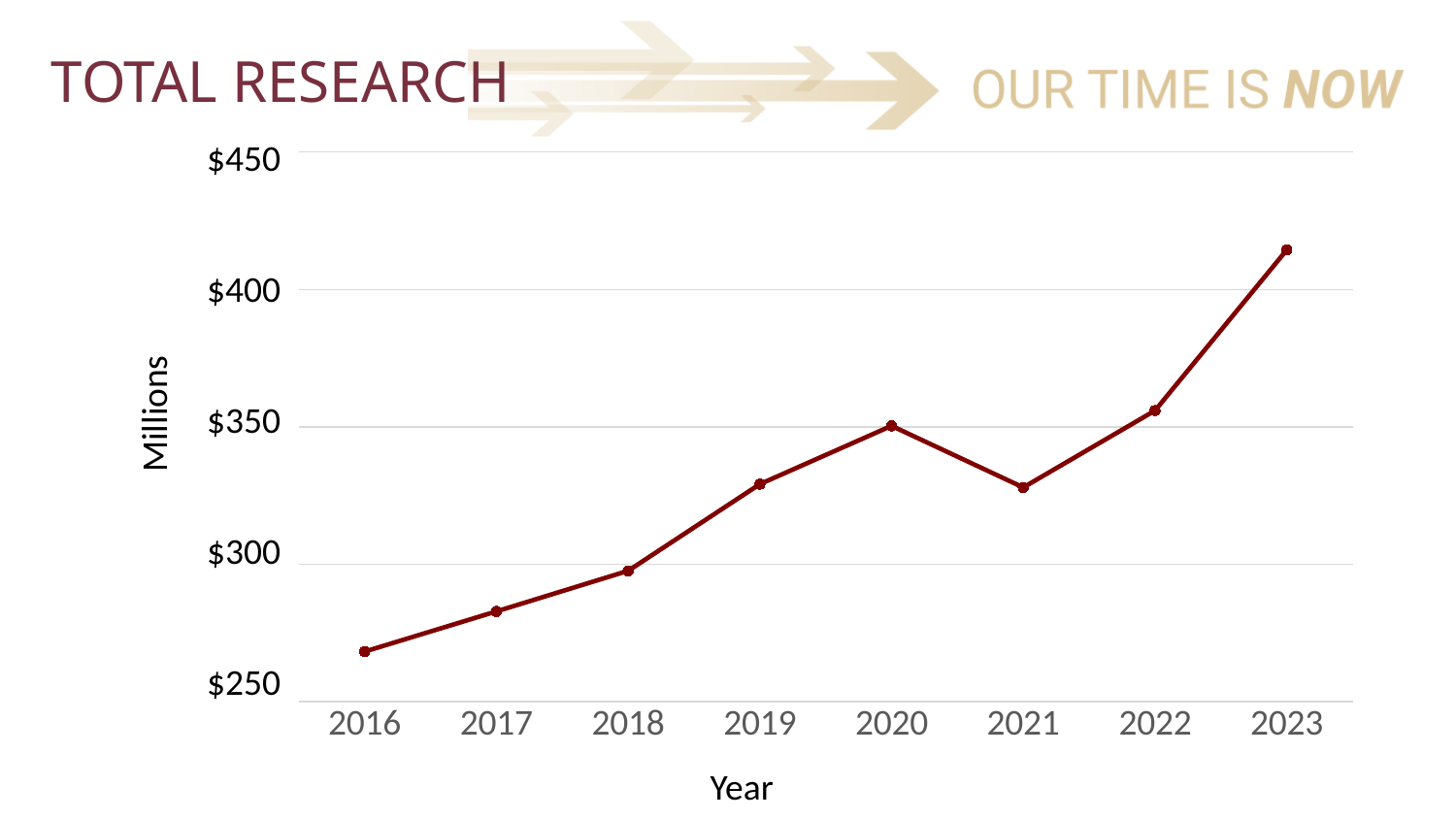
Which year has the lowest total research value? 2016 Which year has the larger value, 2020 or 2021? 2020 Is the value for 2021 greater or less than $350? less How many years are plotted on the x axis? 8 What kind of chart is shown on the slide? line chart Is the value for 2016 greater or less than $300? less Which year has the highest total research value? 2023 Do the values generally rise or fall from 2016 to 2023? rise What is the label on the vertical axis? Millions Is the value for 2019 greater or less than $300? greater What is the title of the chart? TOTAL RESEARCH